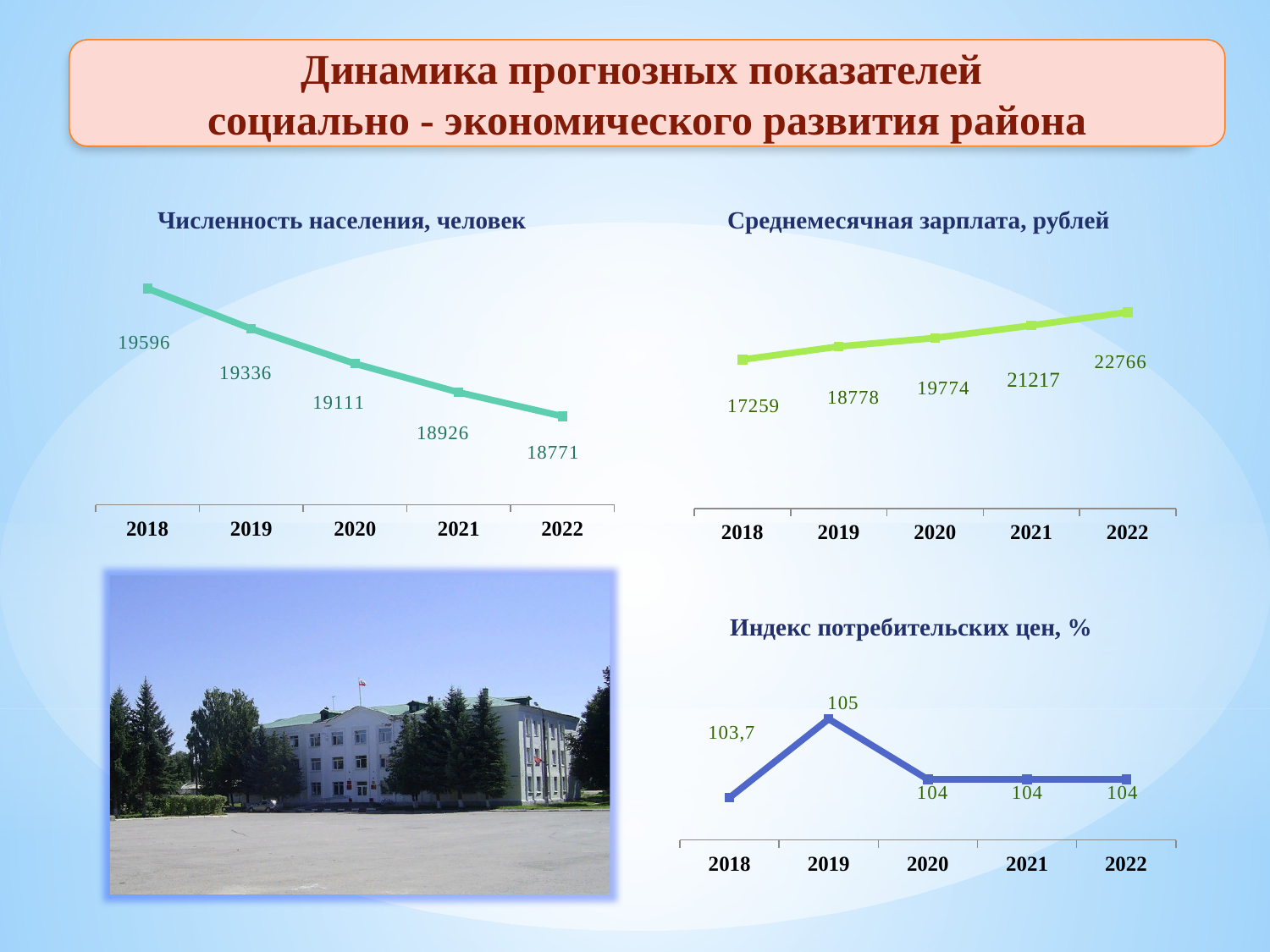
In the chart titled "Индекс потребительских цен, %", what is the value for 2018? 103,7 In the chart titled "Индекс потребительских цен, %", which year has the highest value? 2019 In the chart titled "Среднемесячная зарплата, рублей", what is the difference between the 2022 and 2018 values? 5507 In the chart titled "Численность населения, человек", do the values rise or fall from 2018 to 2022? fall In the chart titled "Индекс потребительских цен, %", how many years are plotted? 5 In the chart titled "Среднемесячная зарплата, рублей", what is the value for 2021? 21217 In the chart titled "Среднемесячная зарплата, рублей", which year has the highest value? 2022 In the chart titled "Среднемесячная зарплата, рублей", do the values rise or fall from 2018 to 2022? rise In the chart titled "Численность населения, человек", which year has the lowest value? 2022 What kind of chart is the chart titled "Индекс потребительских цен, %"? line chart In the chart titled "Численность населения, человек", what is the difference between the 2018 and 2022 values? 825 In the chart titled "Численность населения, человек", what is the value for 2018? 19596